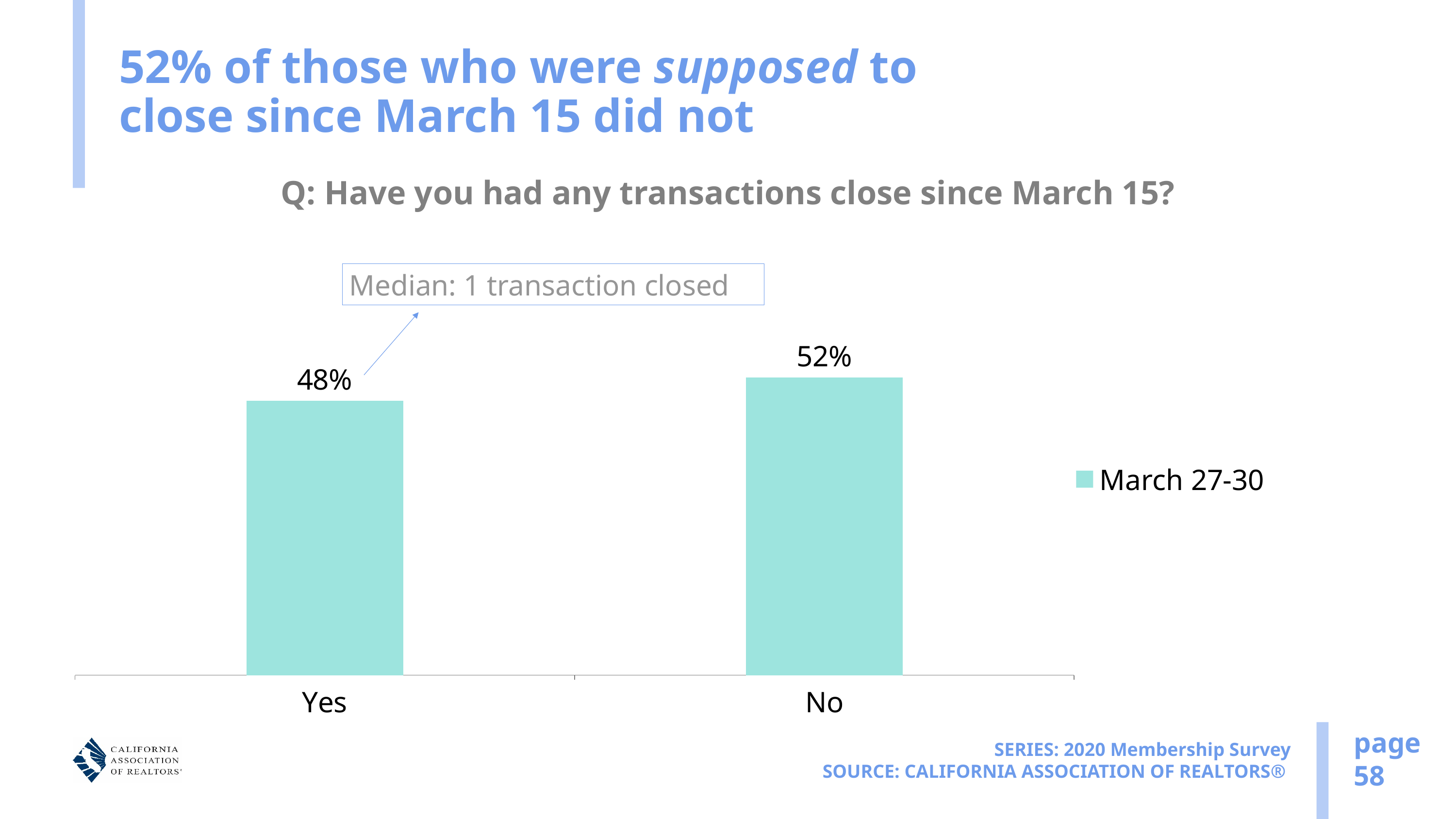
Is the value for No larger than the value for Yes? Yes What kind of chart is shown on the slide? Bar chart Which category has the higher value, Yes or No? No Which category has the lower value? Yes How many series does the legend list? 1 What is the total of the Yes and No values? 100% What does the annotation box above the Yes bar say? Median: 1 transaction closed How many categories are shown on the x axis? 2 What series name is shown in the legend? March 27-30 What is the difference in percentage points between the No and Yes bars? 4 What percentage of respondents answered No? 52% What percentage of respondents answered Yes? 48%